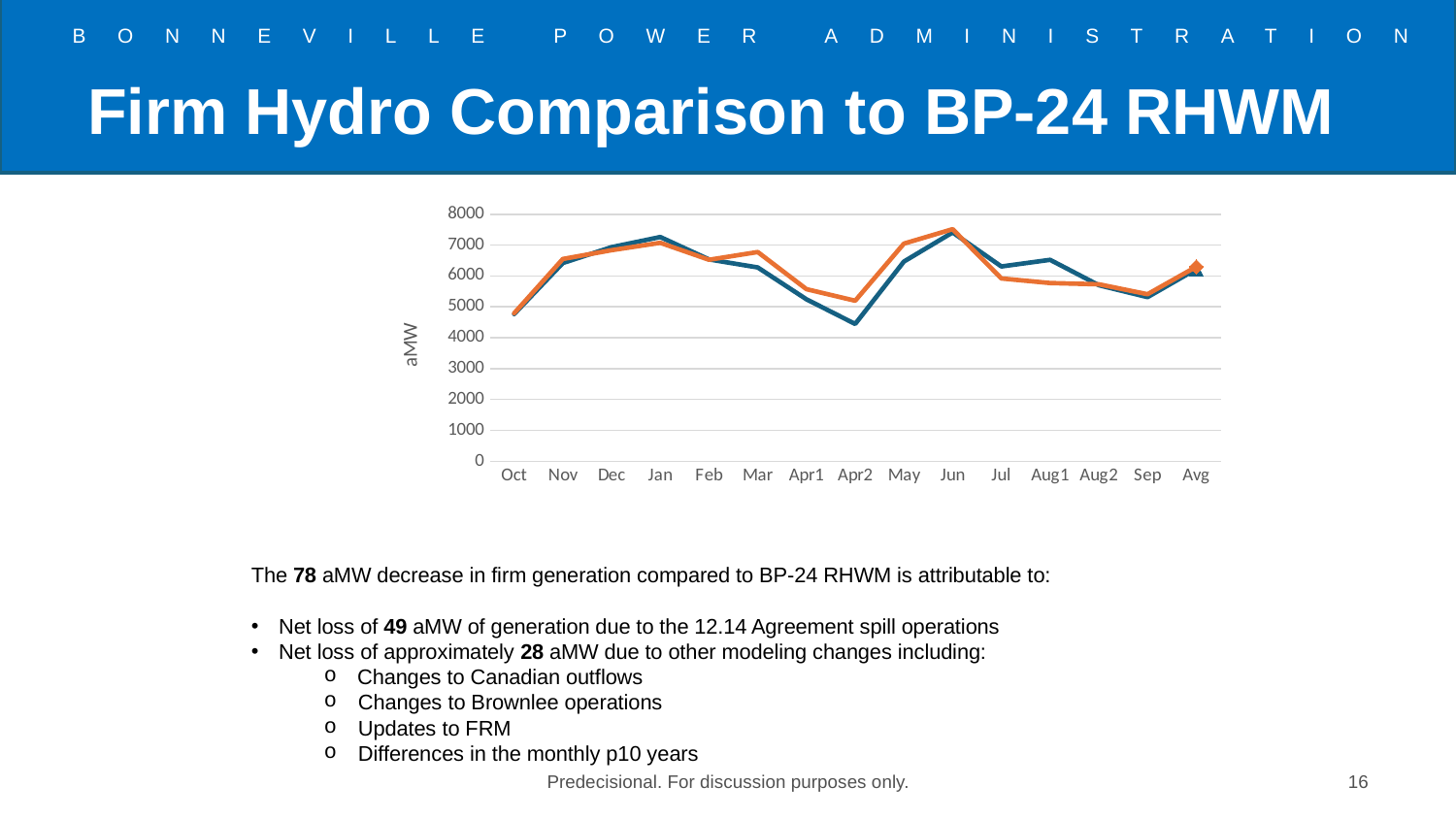
What is the label on the vertical axis of the chart? aMW Is the value of the blue line for Apr2 greater or less than 5000? less At Aug1, which line has the higher value, the blue line or the orange line? blue line Is the value of the orange line for May greater or less than 6000? greater What kind of chart is shown on the slide? line chart Which category has the lowest value on the blue line? Apr2 Does the blue line rise or fall from Jan to Apr2? fall Which category has the lowest value on the orange line? Oct What is the highest value shown on the vertical axis of the chart? 8000 At Apr2, which line has the higher value, the blue line or the orange line? orange line Which category has the highest value on the orange line? Jun How many categories are shown along the x axis of the chart? 15